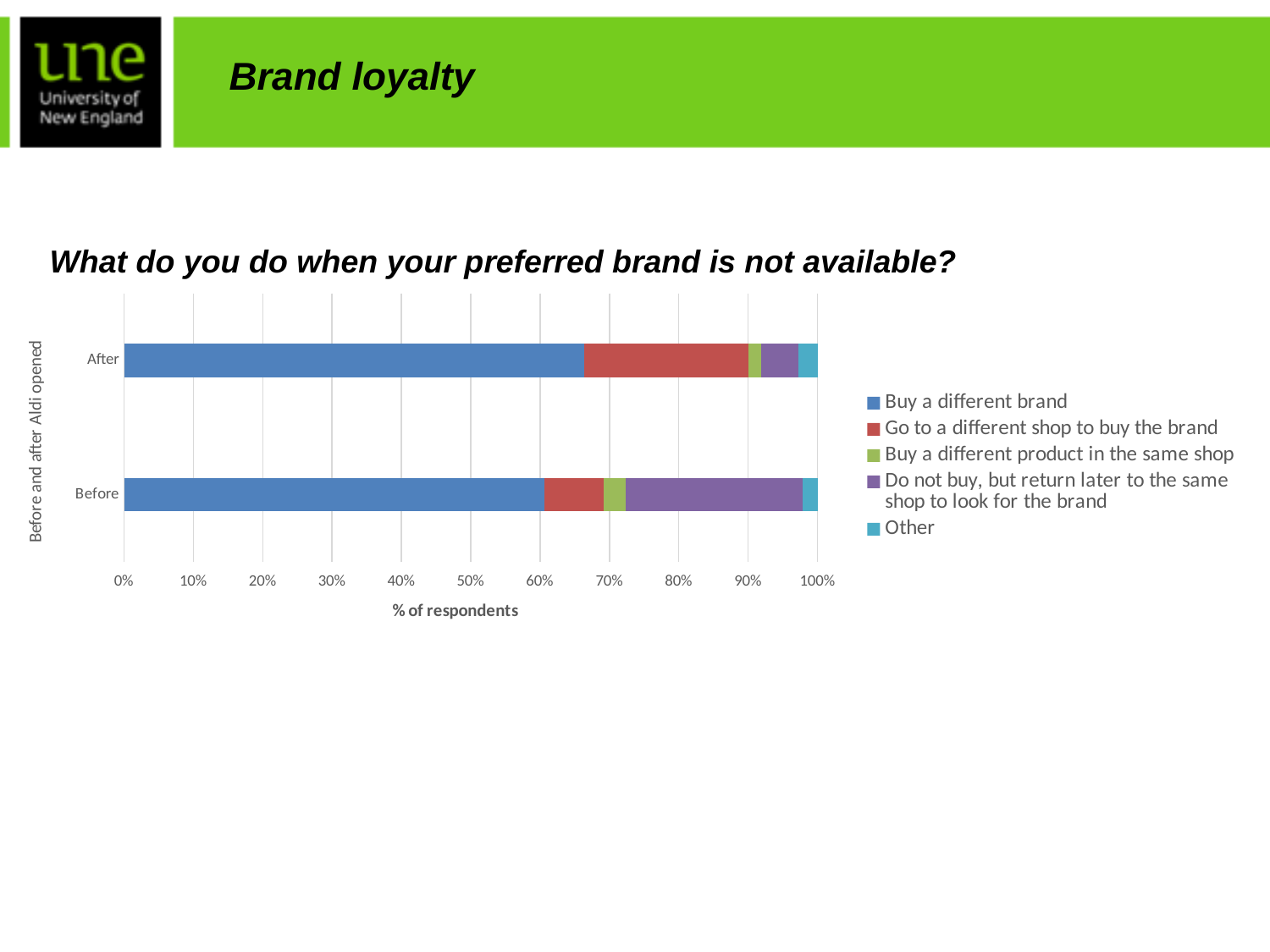
Is the value for "Buy a different brand" in the After bar greater or less than 70%? less What is the title of the chart's vertical axis? Before and after Aldi opened Which series takes up the largest share of the After bar? Buy a different brand What kind of chart is shown on the slide? Stacked bar chart Is the "Do not buy, but return later to the same shop to look for the brand" segment larger in the Before bar or the After bar? Before Is the value for "Buy a different brand" in the Before bar greater or less than 50%? greater Is the value for "Buy a different brand" in the After bar greater or less than 60%? greater Which series takes up the largest share of the Before bar? Buy a different brand How many series does the chart's legend list? 5 Is the "Go to a different shop to buy the brand" segment larger in the After bar or the Before bar? After How many categories are shown on the vertical axis of the chart? 2 What is the title of the chart's horizontal axis? % of respondents